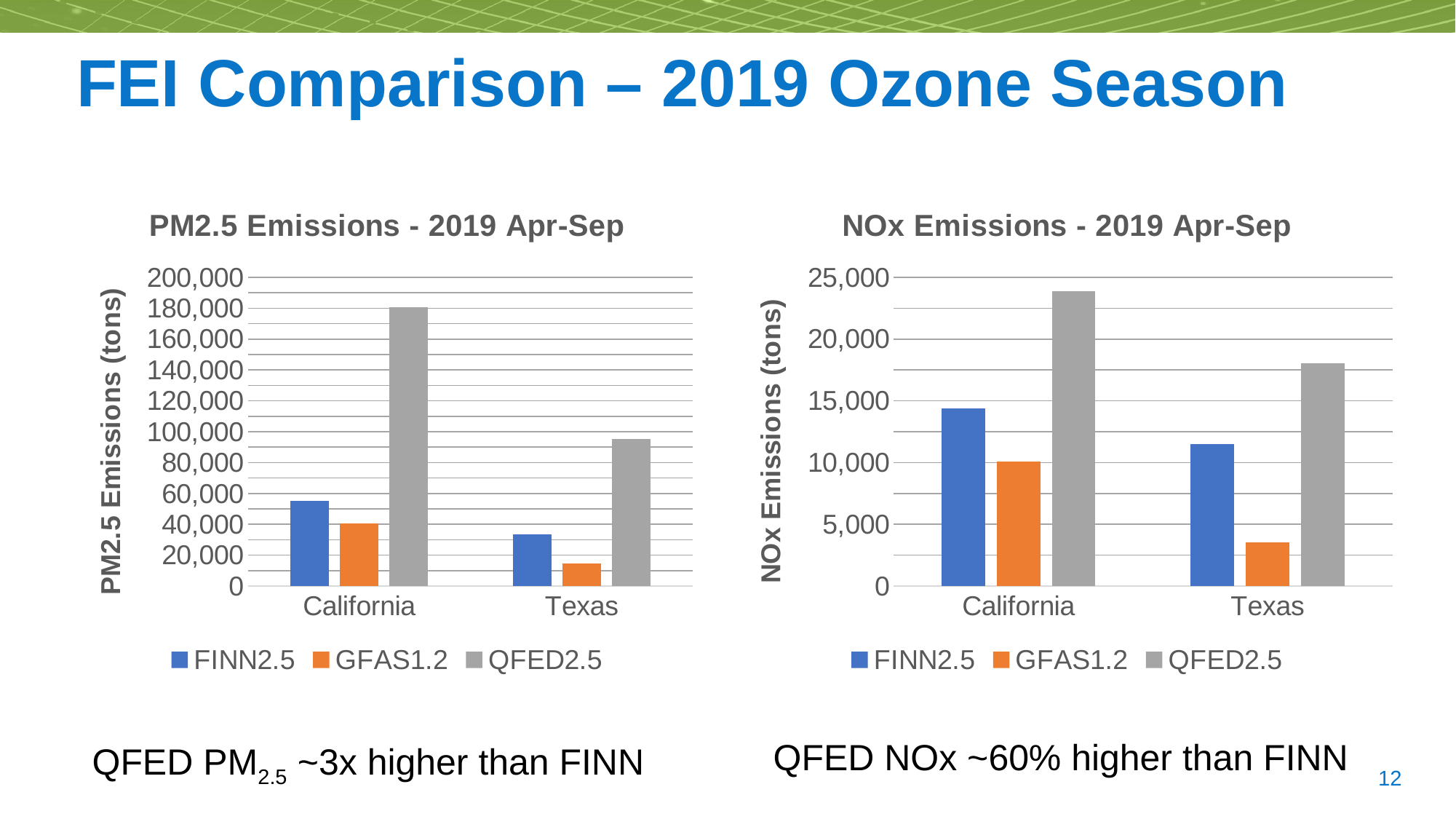
In the NOx Emissions - 2019 Apr-Sep chart, is the GFAS1.2 value for Texas greater or less than 5,000? less In the PM2.5 Emissions - 2019 Apr-Sep chart, which series has the highest value for California? QFED2.5 In the PM2.5 Emissions - 2019 Apr-Sep chart, is the GFAS1.2 value for Texas greater or less than 20,000? less In the PM2.5 Emissions - 2019 Apr-Sep chart, which series has the lowest value for Texas? GFAS1.2 In the NOx Emissions - 2019 Apr-Sep chart, which series has the highest value for Texas? QFED2.5 In the PM2.5 Emissions - 2019 Apr-Sep chart, which is larger: the FINN2.5 value for California or the FINN2.5 value for Texas? California How many series does the legend of the NOx Emissions - 2019 Apr-Sep chart list? 3 In the NOx Emissions - 2019 Apr-Sep chart, is the QFED2.5 value for California greater or less than 20,000? greater In the NOx Emissions - 2019 Apr-Sep chart, which series has the lowest value for California? GFAS1.2 In the NOx Emissions - 2019 Apr-Sep chart, which is larger: the FINN2.5 value for California or the GFAS1.2 value for California? FINN2.5 What kind of chart is the PM2.5 Emissions - 2019 Apr-Sep chart? bar chart